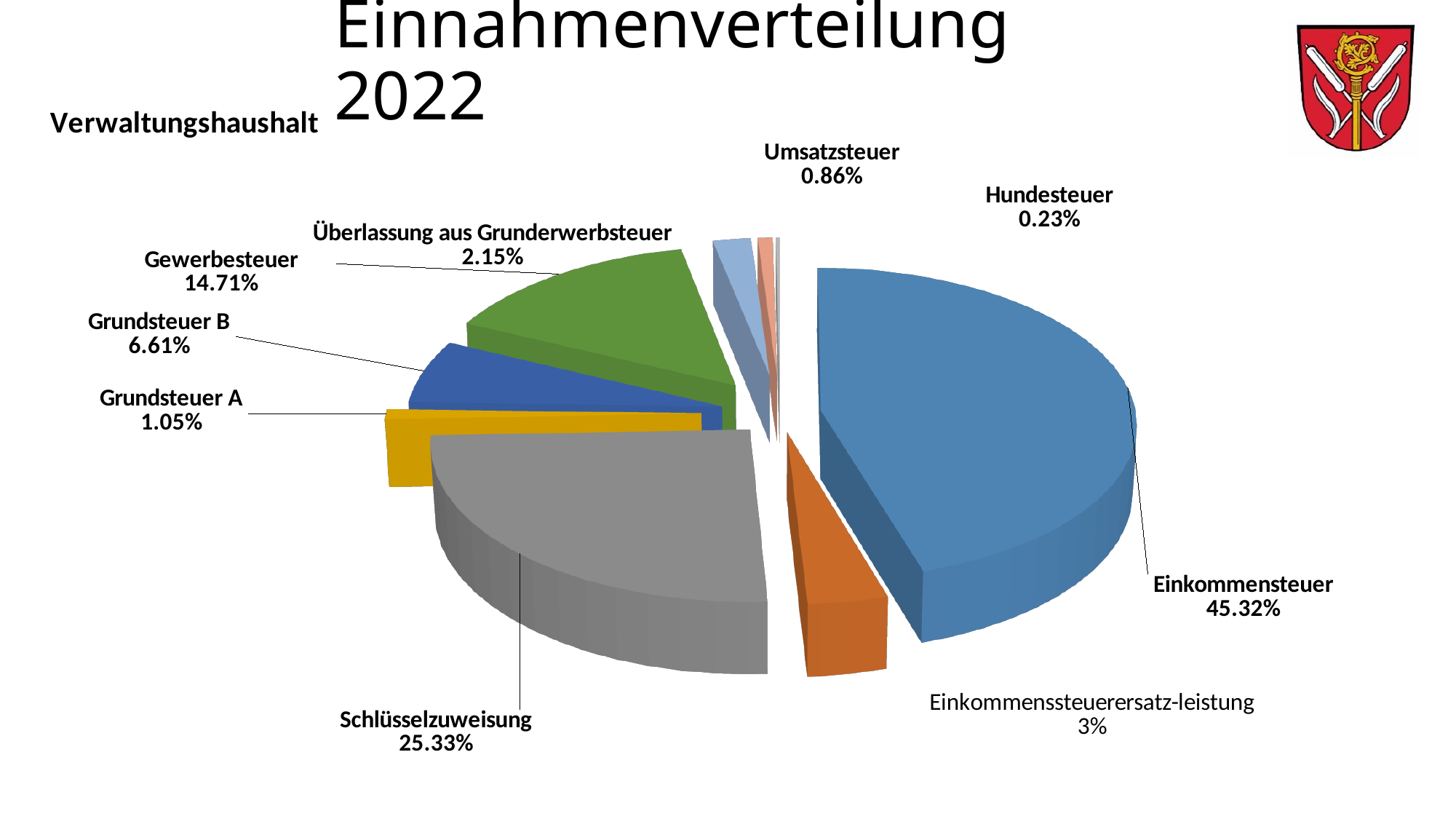
Which category has the smallest slice of the pie? Hundesteuer What is the value labelled for Gewerbesteuer? 14.71% What share of the pie does Einkommensteuer have? 45.32% How many categories are shown in the pie chart? 9 Which category has the largest slice of the pie? Einkommensteuer What is the title of the slide containing the chart? Einnahmenverteilung 2022 Which is larger, Grundsteuer A or Grundsteuer B? Grundsteuer B What kind of chart is shown on the slide? Pie chart What percentage is shown for Grundsteuer B? 6.61% What percentage is shown for Schlüsselzuweisung? 25.33% What share is labelled for Hundesteuer? 0.23% What is the difference in percentage points between Einkommensteuer and Schlüsselzuweisung? 19.99